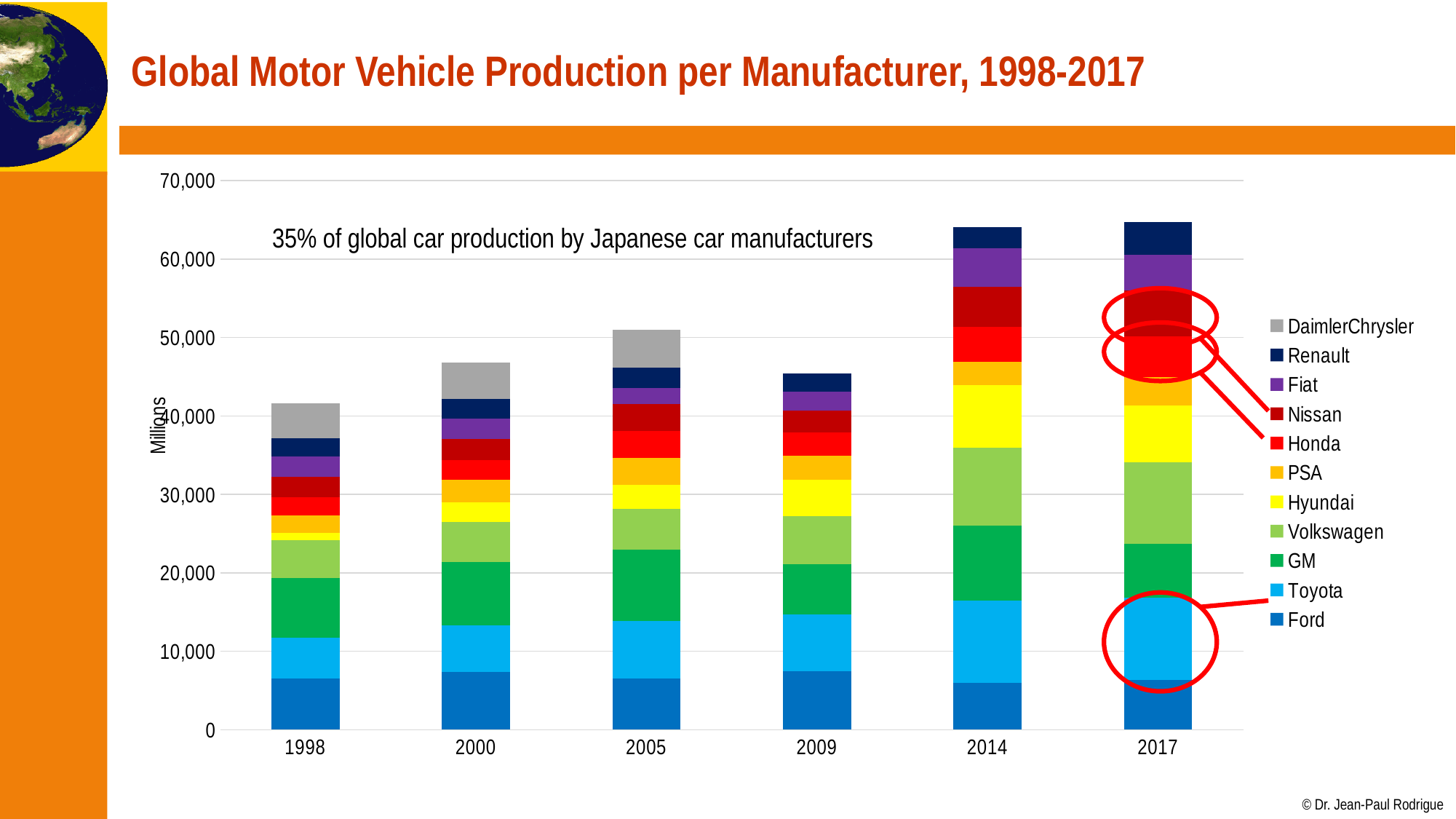
Is the total production for 1998 greater or less than 40,000? greater Which manufacturer is shown at the bottom of each stacked bar? Ford Which year has the larger total production, 2009 or 2014? 2014 What kind of chart is shown on the slide? Stacked bar chart Which year has the lowest total motor vehicle production in the chart? 1998 How many manufacturers does the legend list? 11 Do the total production values rise steadily from 1998 to 2017, or is there a dip? There is a dip in 2009 How many years are shown along the x axis of the chart? 6 Is the total production for 2000 greater or less than 50,000? less What annotation text is written inside the chart area? 35% of global car production by Japanese car manufacturers Is the total production for 2009 greater or less than 50,000? less